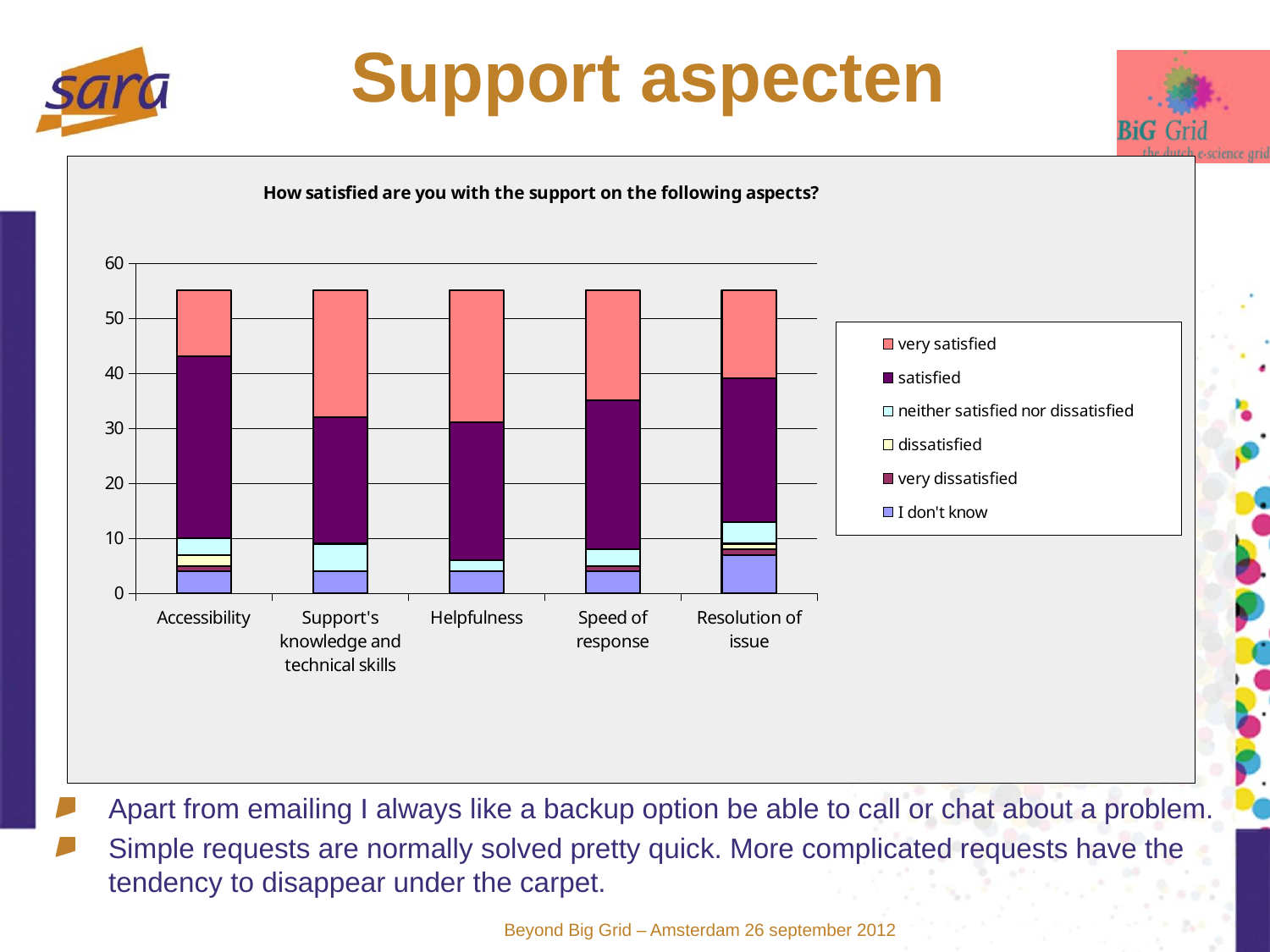
Is the top of the 'satisfied' segment in the Accessibility bar greater or less than 40? greater Is the 'I don't know' segment for Resolution of issue greater or less than 10? less How many series does the legend list? 6 Which category has the largest 'satisfied' segment? Accessibility Is the total height of the Accessibility bar greater or less than 50? greater How many support aspects (categories) are shown on the x axis? 5 What is the title of the chart? How satisfied are you with the support on the following aspects? Which has the larger 'very satisfied' segment: Accessibility or Support's knowledge and technical skills? Support's knowledge and technical skills What kind of chart is shown on the slide? stacked bar chart Which category has the largest 'I don't know' segment? Resolution of issue Which has the larger 'satisfied' segment: Accessibility or Helpfulness? Accessibility Which legend entry is listed first (at the top of the legend)? very satisfied